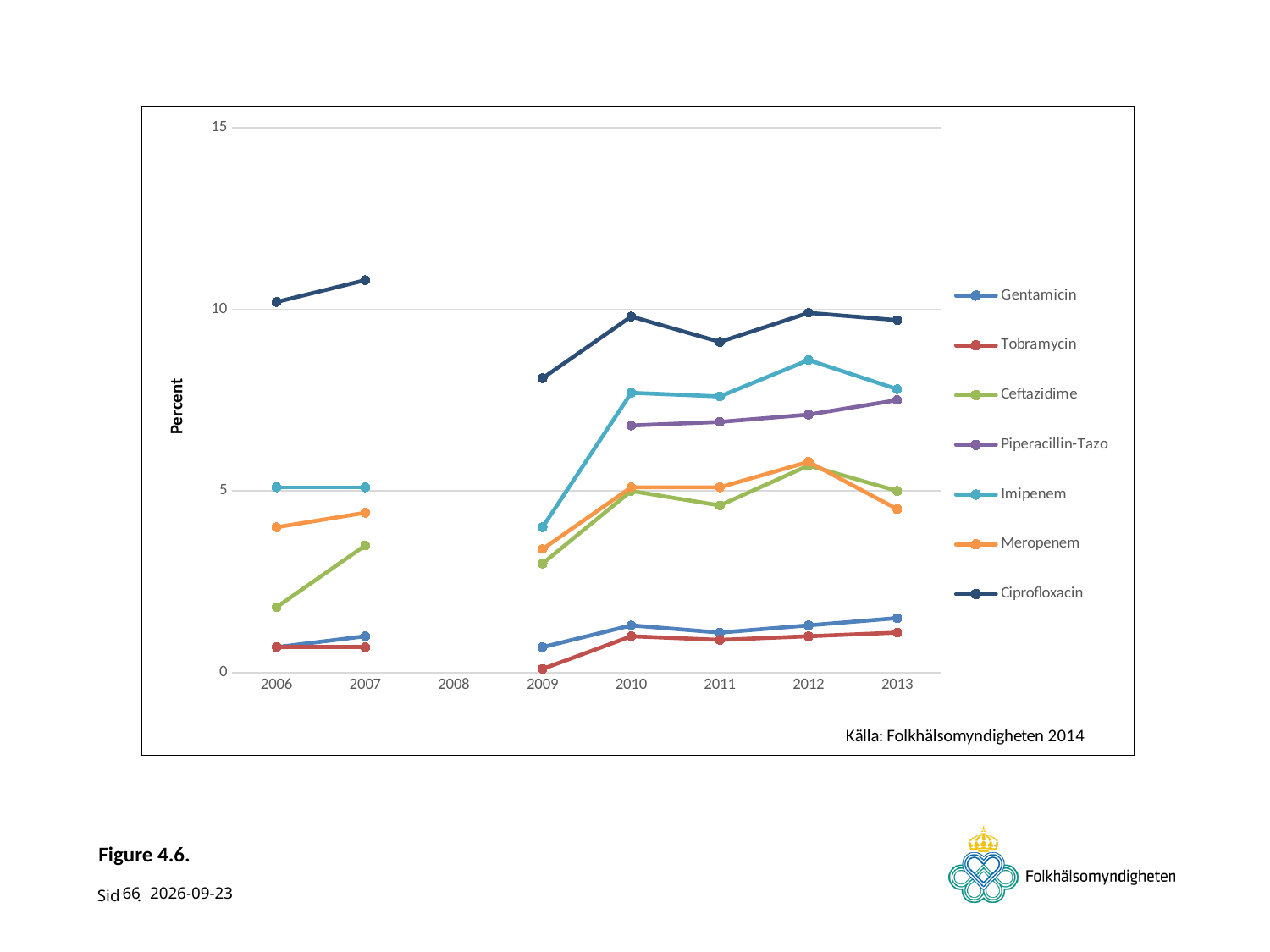
What kind of chart is shown on the slide? line chart Which series has the lowest value in 2009? Tobramycin What is the label on the y axis? Percent Is the value for Ciprofloxacin in 2009 greater or less than 10? less How many years are labelled on the x axis? 8 Is the value for Ciprofloxacin in 2007 greater or less than 10? greater Is the value for Ceftazidime in 2006 greater or less than 5? less Does the Ciprofloxacin line rise or fall from 2006 to 2007? rise In 2010, which is higher: Imipenem or Piperacillin-Tazo? Imipenem Which series has the highest value in 2013? Ciprofloxacin How many series does the legend list? 7